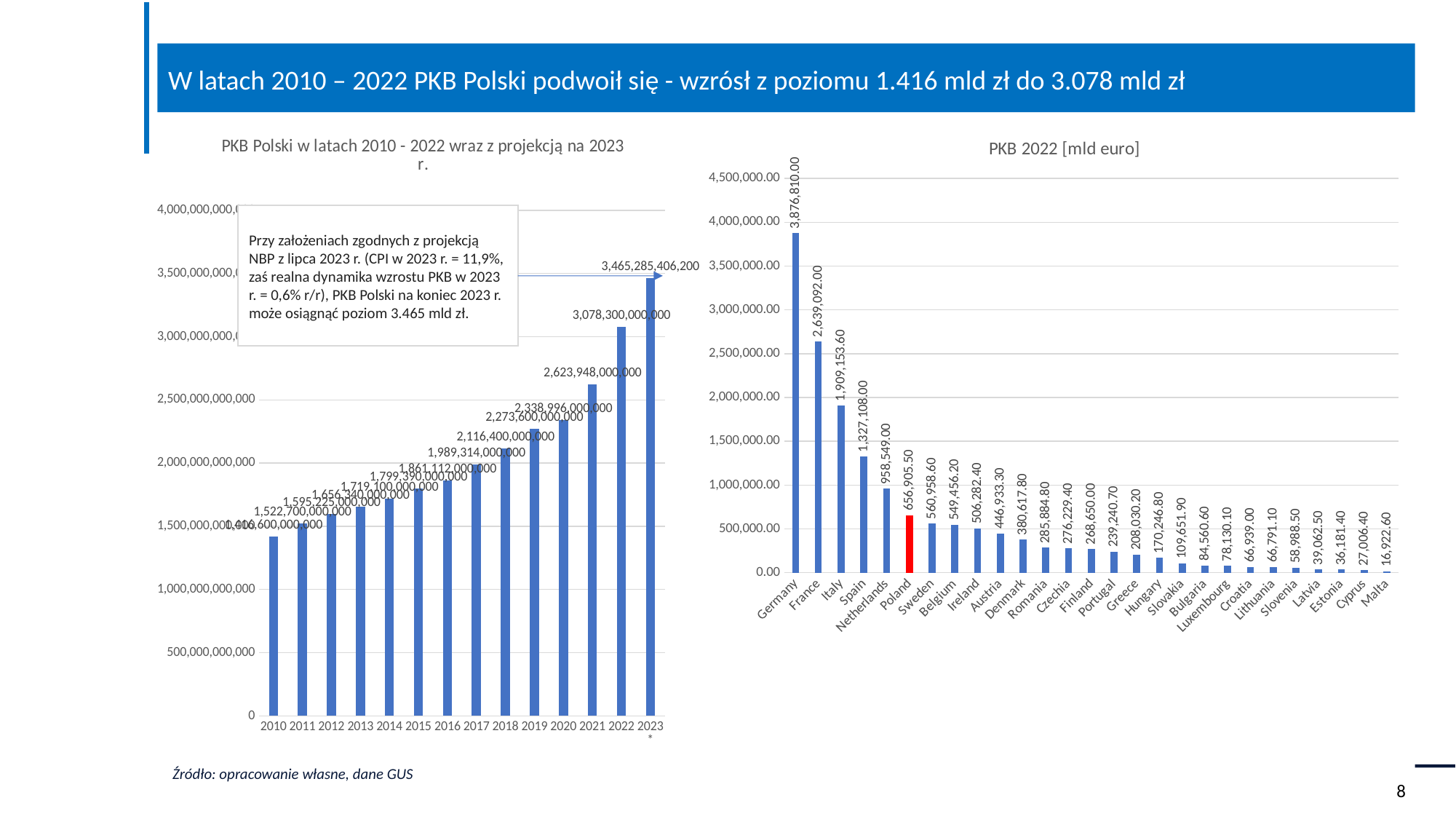
In the chart titled "PKB 2022 [mld euro]", what is the difference between the values for Germany and France? 1,237,718.00 In the chart titled "PKB 2022 [mld euro]", which country has the lowest value? Malta In the chart titled "PKB 2022 [mld euro]", how many countries are shown? 27 In the left chart (PKB Polski w latach 2010 - 2022), what is the value for 2022? 3,078,300,000,000 In the chart titled "PKB 2022 [mld euro]", which country's bar is coloured red? Poland In the left chart (PKB Polski w latach 2010 - 2022), what is the projected value for 2023*? 3,465,285,406,200 What kind of chart is the left chart (PKB Polski w latach 2010 - 2022)? bar chart In the left chart (PKB Polski w latach 2010 - 2022), do the values rise or fall from 2010 to 2023? rise In the chart titled "PKB 2022 [mld euro]", which country has the highest value? Germany In the chart titled "PKB 2022 [mld euro]", which is larger, the value for Sweden or the value for Belgium? Sweden In the chart titled "PKB 2022 [mld euro]", what is the value for Poland? 656,905.50 In the chart titled "PKB 2022 [mld euro]", what is the value for France? 2,639,092.00